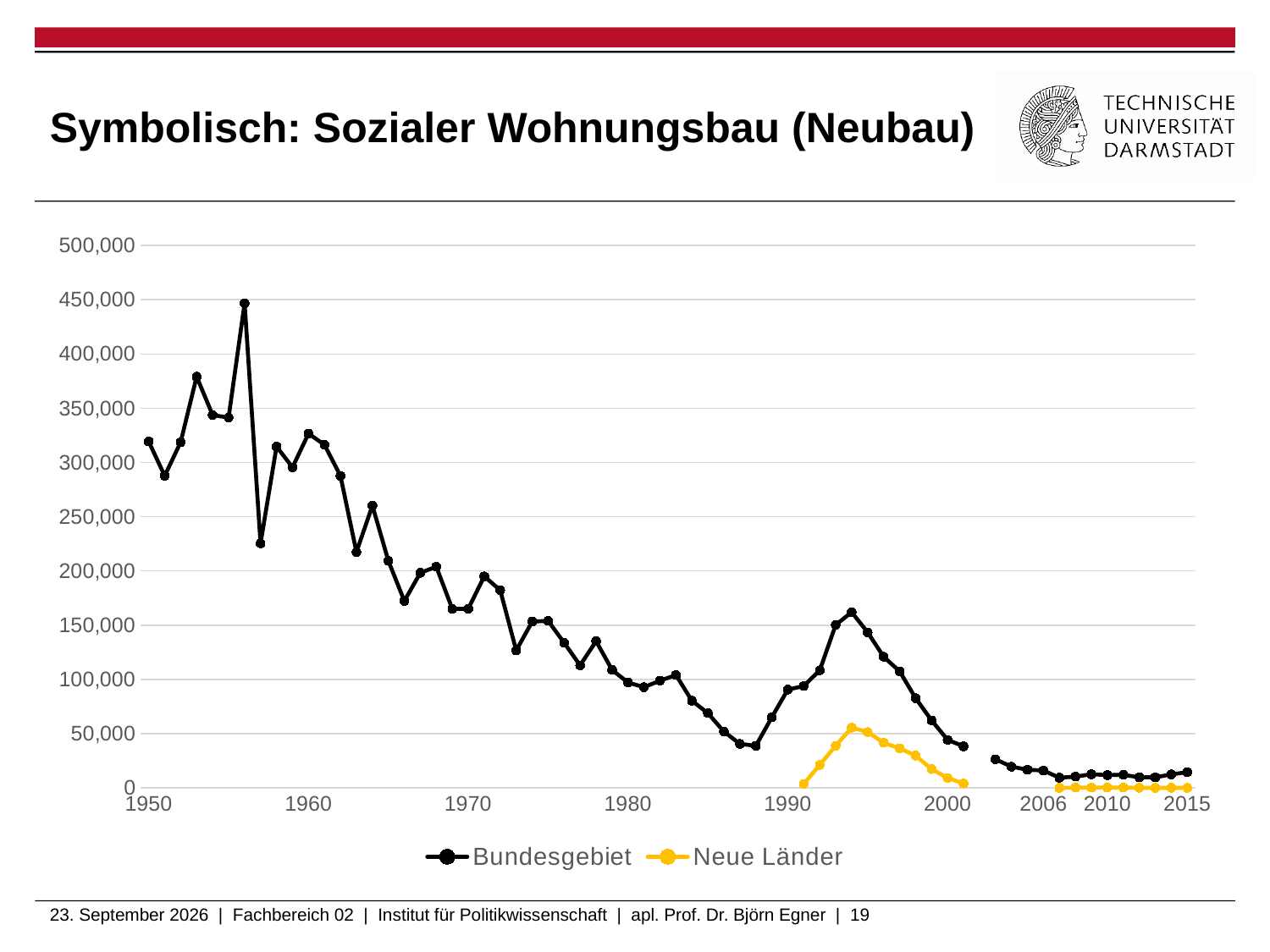
What is the title of the slide containing the chart? Symbolisch: Sozialer Wohnungsbau (Neubau) How many series does the legend list? 2 Is the value for Bundesgebiet in 2015 greater or less than 50,000? less Is the value for Bundesgebiet in 1990 greater or less than 150,000? less Overall, does the Bundesgebiet series rise or fall from 1950 to 2015? fall Is the highest value of the Neue Länder series greater or less than 100,000? less Which series reaches the highest value anywhere on the chart? Bundesgebiet In 2000, which series has the larger value, Bundesgebiet or Neue Länder? Bundesgebiet What kind of chart is shown on the slide? line chart What are the two series named in the legend? Bundesgebiet and Neue Länder